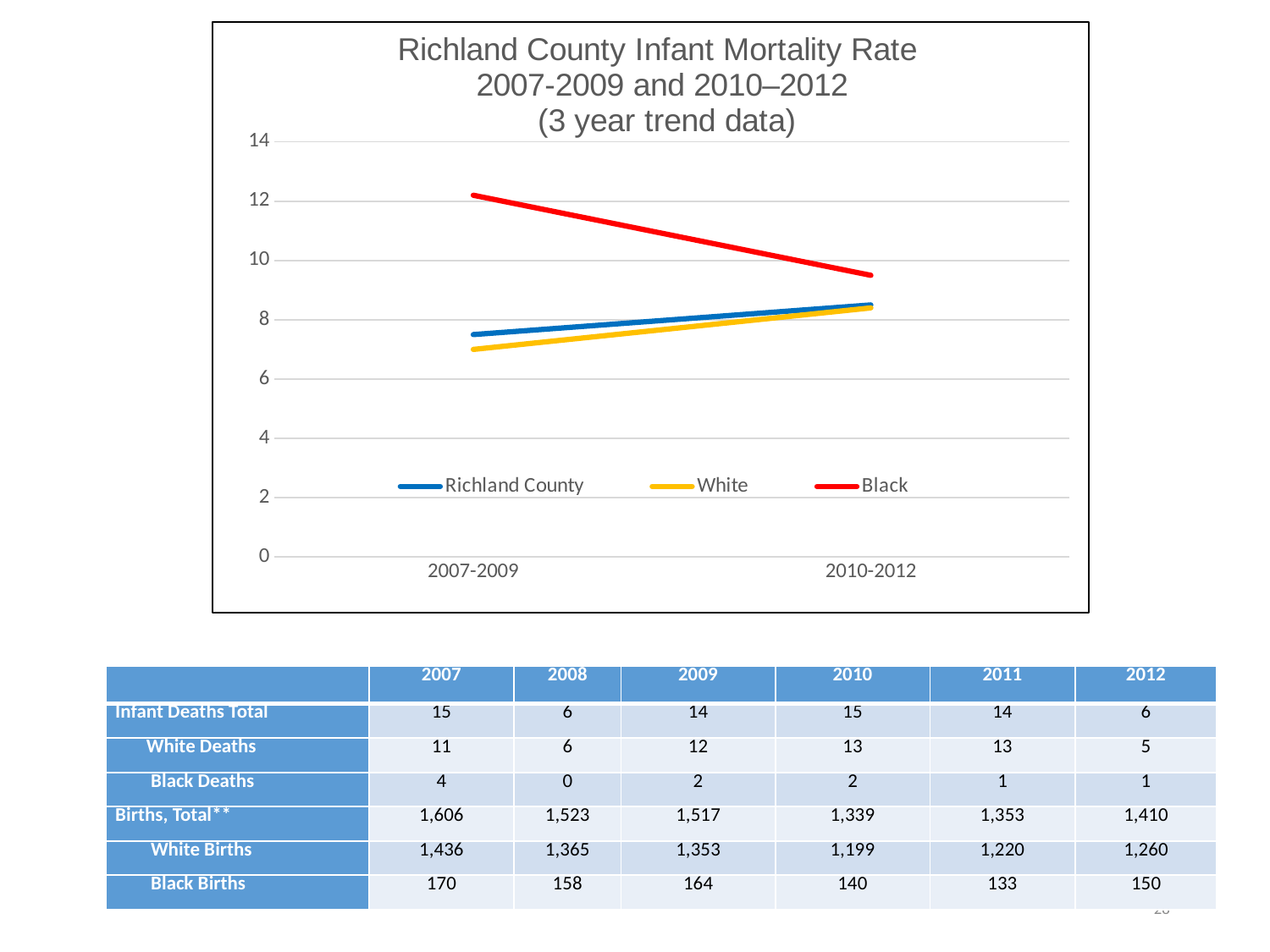
Is the value for Black in 2007-2009 greater or less than 10? greater Does the White infant mortality rate rise or fall from 2007-2009 to 2010-2012? rise What kind of chart is shown on the slide? line chart Which series has the lowest infant mortality rate in 2007-2009? White Does the Black infant mortality rate rise or fall from 2007-2009 to 2010-2012? fall Is the value for White in 2007-2009 greater or less than 8? less Which is larger in 2010-2012, the value for Black or the value for Richland County? Black Which series has the highest infant mortality rate in 2007-2009? Black What colour is the line for the Black series in the chart? red How many series does the chart legend list? 3 How many time periods are shown on the x axis of the chart? 2 Is the value for Black in 2010-2012 greater or less than 10? less